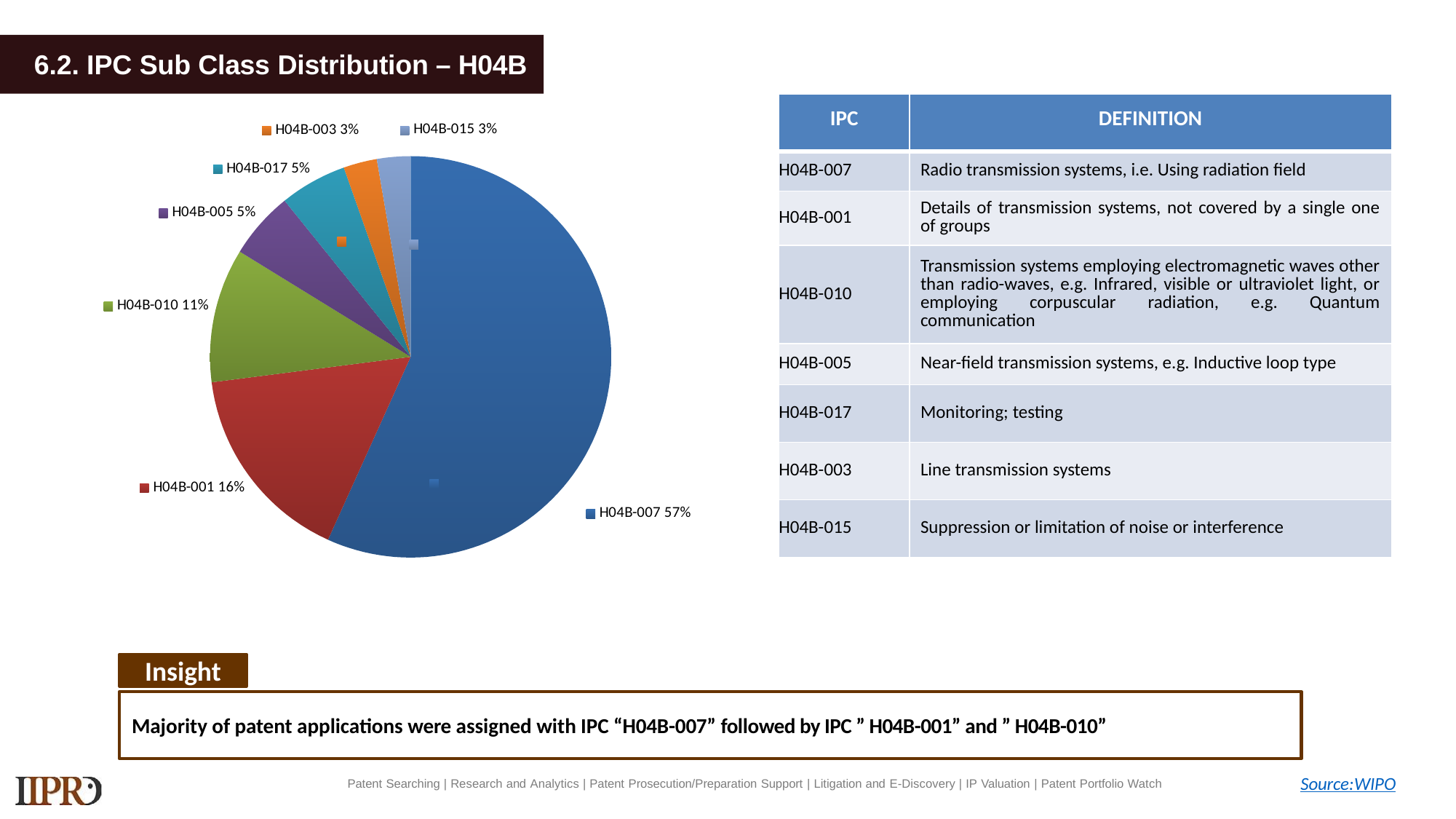
What share of the pie chart does H04B-007 represent? 57% What is the combined share of H04B-003 and H04B-015 in the pie chart? 6% Which IPC sub class has the largest slice in the pie chart? H04B-007 Which has a larger share, H04B-001 or H04B-017? H04B-001 What percentage is shown for H04B-010 in the pie chart? 11% What is the difference in percentage points between H04B-007 and H04B-001? 41 What percentage is shown for H04B-017 in the pie chart? 5% What type of chart is used to show the IPC sub class distribution? Pie chart Which has a larger share, H04B-010 or H04B-005? H04B-010 What percentage is shown for H04B-001 in the pie chart? 16% How many IPC sub classes are shown in the pie chart? 7 What is the difference in percentage points between H04B-001 and H04B-010? 5